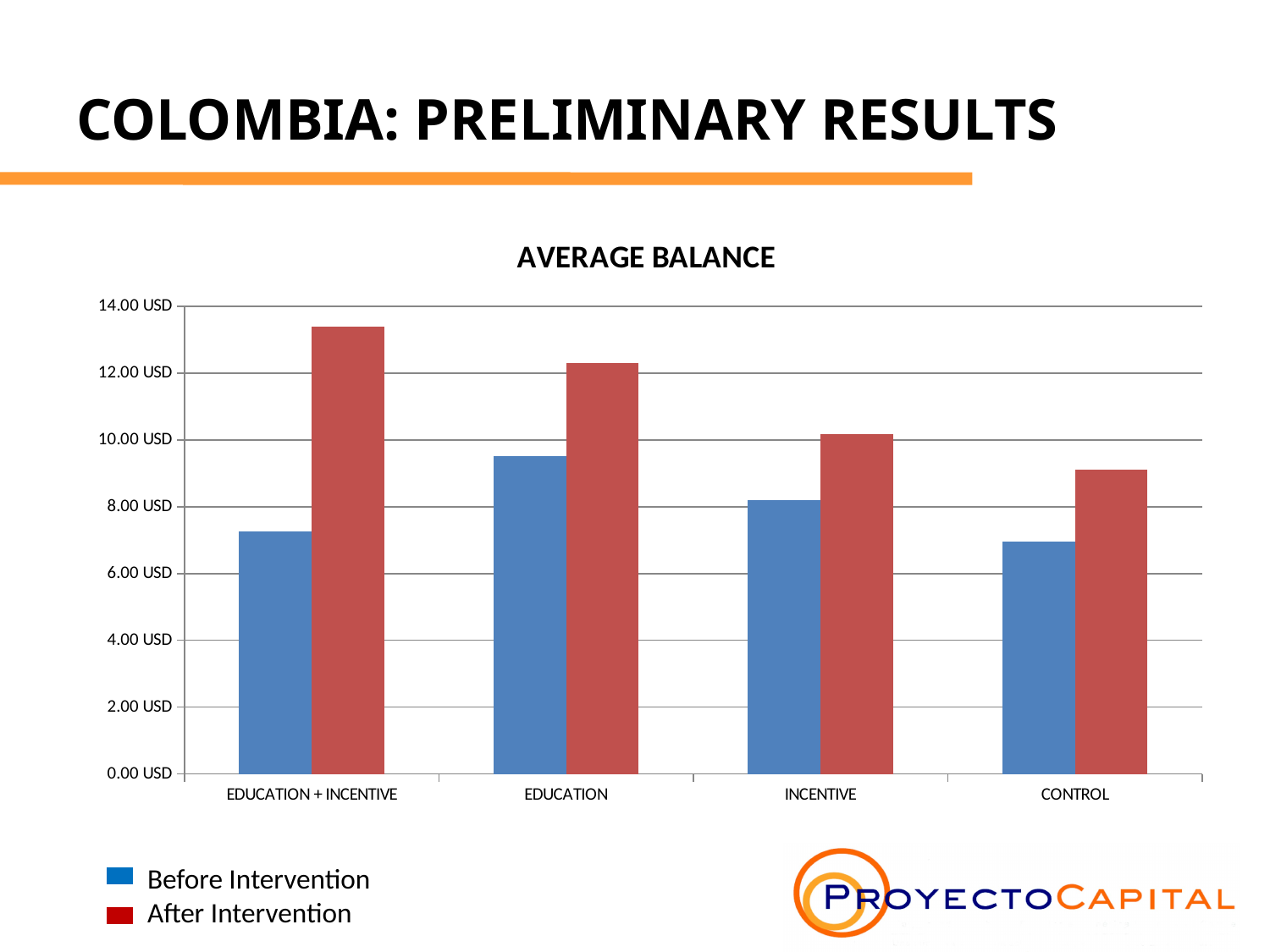
Which category has the lowest After Intervention value? CONTROL For EDUCATION, which is larger: the Before Intervention value or the After Intervention value? After Intervention Do the After Intervention values rise or fall from EDUCATION + INCENTIVE to CONTROL along the x axis? fall Is the After Intervention value for EDUCATION + INCENTIVE greater or less than 12.00 USD? greater Which category has the highest Before Intervention value? EDUCATION How many categories are shown on the x axis of the chart? 4 Which category has the highest After Intervention value? EDUCATION + INCENTIVE Is the Before Intervention value for CONTROL greater or less than 8.00 USD? less How many series does the legend list? 2 What is the title of the chart? AVERAGE BALANCE What kind of chart is shown on the slide? bar chart